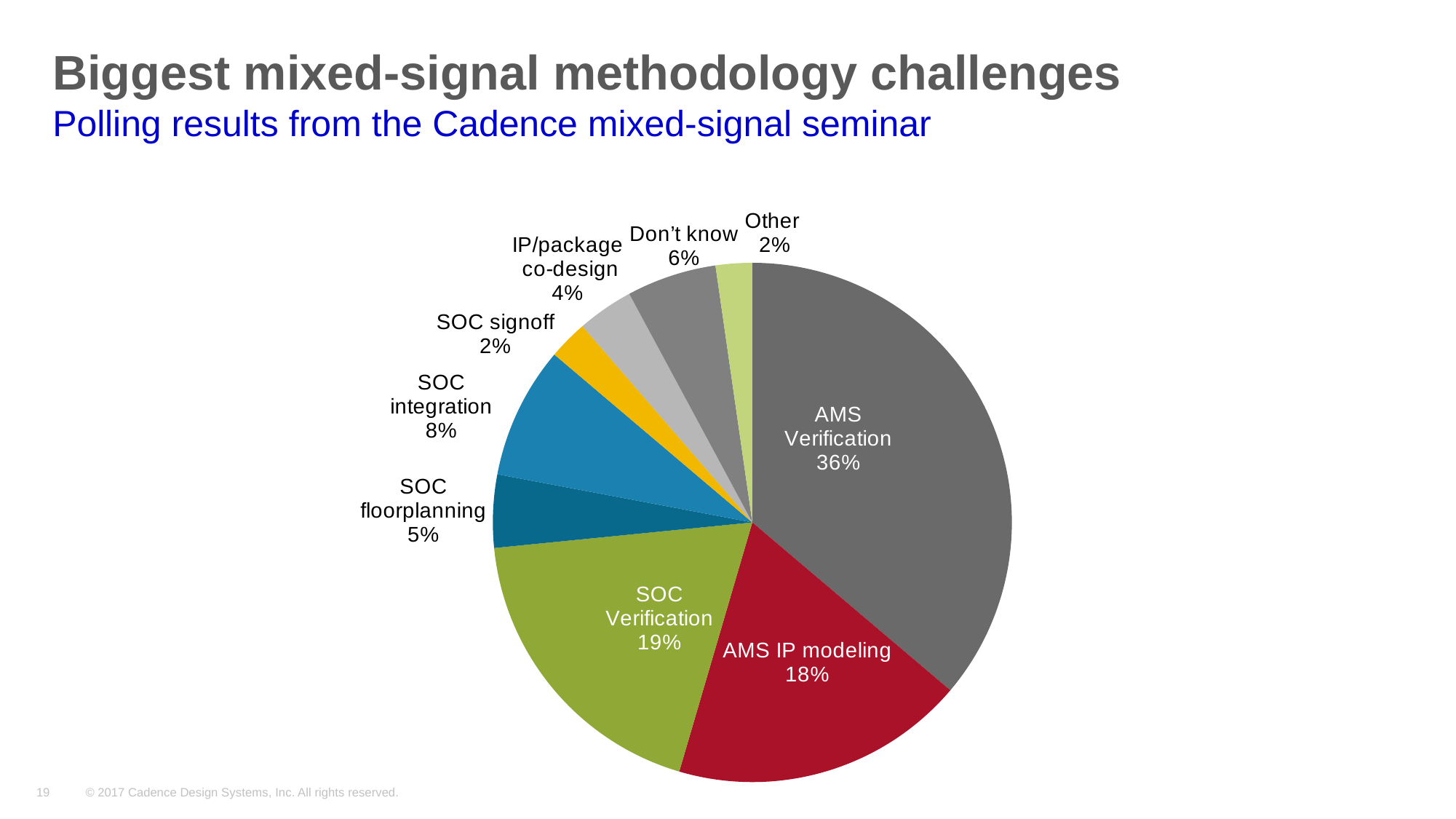
What is the value for Don't know? 6% What is the subtitle of the slide below the chart title? Polling results from the Cadence mixed-signal seminar What is the difference between AMS Verification and SOC Verification? 17% What kind of chart is shown on the slide? pie chart Which is larger, SOC integration or SOC floorplanning? SOC integration What is the difference between SOC floorplanning and IP/package co-design? 1% What is the value for SOC integration? 8% What is the value for AMS IP modeling? 18% Which category has the largest slice of the pie? AMS Verification What share of the pie does AMS Verification have? 36% What is the value for SOC Verification? 19% How many slices does the pie chart have? 9